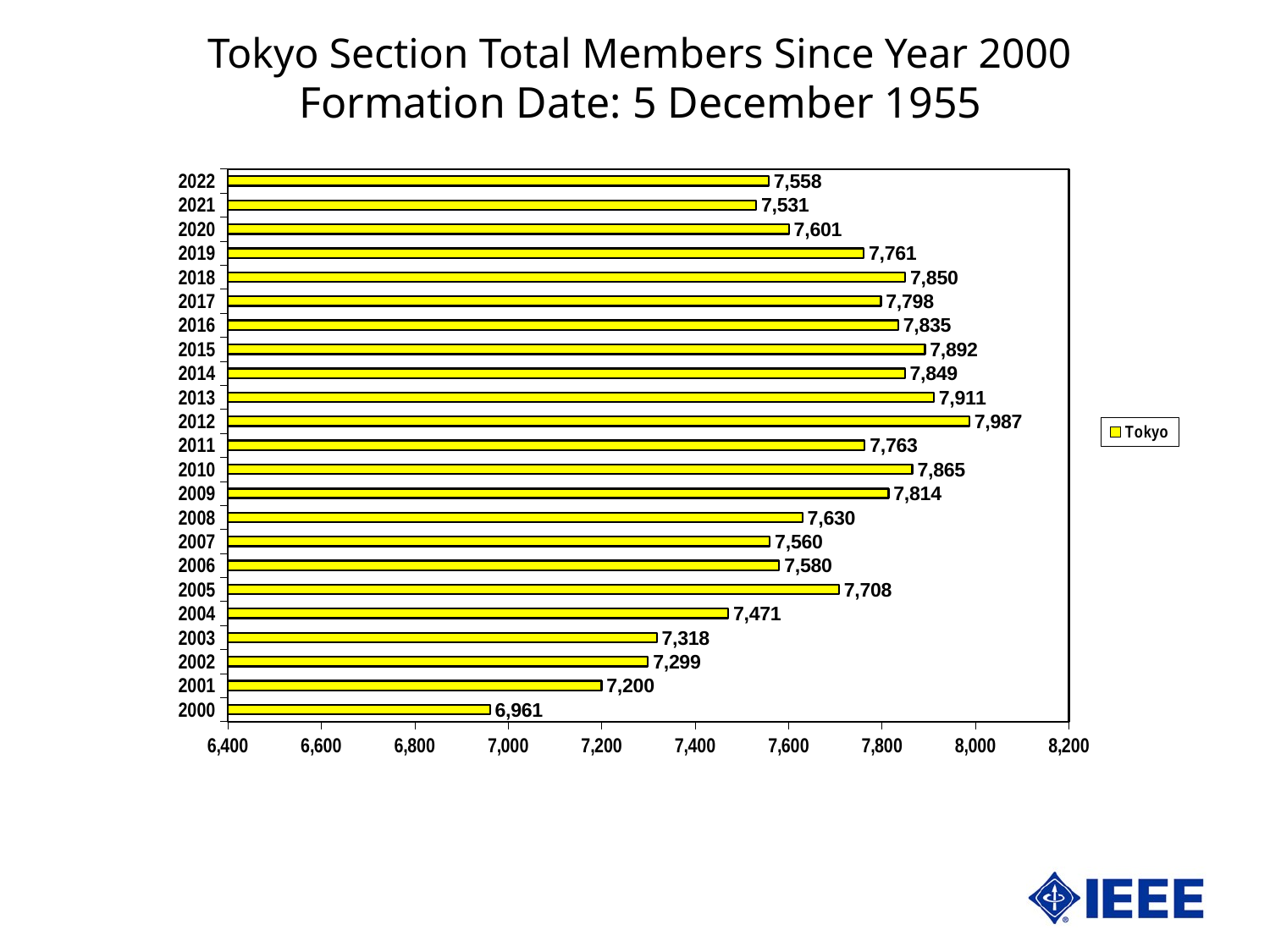
Which year had more members, 2018 or 2019? 2018 What series name does the legend show? Tokyo How many years are shown on the chart? 23 What was the Tokyo Section total membership in 2000? 6,961 What was the Tokyo Section total membership in 2012? 7,987 Which year had the lowest total membership? 2000 What was the Tokyo Section total membership in 2022? 7,558 What kind of chart is shown on the slide? Bar chart Is the value for 2004 greater or less than 7,400? greater What is the difference in membership between 2012 and 2000? 1,026 Which year had the highest total membership? 2012 What is the difference in membership between 2022 and 2021? 27